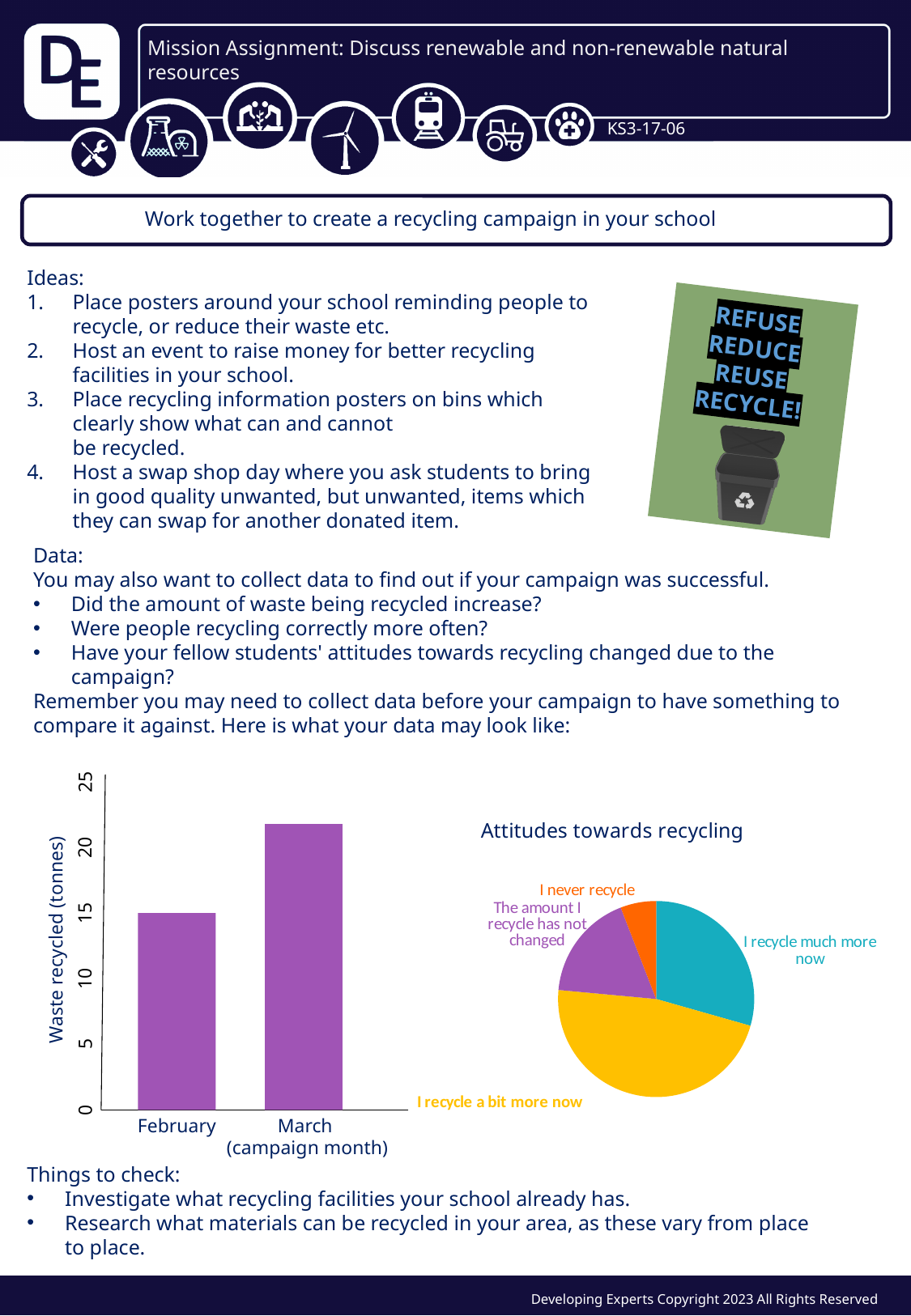
What type of chart is the chart titled 'Attitudes towards recycling'? pie chart In the bar chart on the left, how many months are shown on the x axis? 2 What type of chart is the chart on the left of the slide showing waste recycled? bar chart In the pie chart 'Attitudes towards recycling', how many slices are there? 4 In the bar chart on the left, which month has the higher amount of waste recycled? March In the bar chart on the left, is the value for March greater or less than 20? greater In the bar chart on the left, does the amount of waste recycled rise or fall from February to March? rise In the bar chart on the left, is the value for February greater or less than 10? greater In the bar chart on the left, is the value for February greater or less than 20? less In the pie chart 'Attitudes towards recycling', which attitude has the largest slice? I recycle a bit more now In the bar chart on the left, which month has the lower amount of waste recycled? February In the bar chart on the left, what is the label of the y axis? Waste recycled (tonnes)